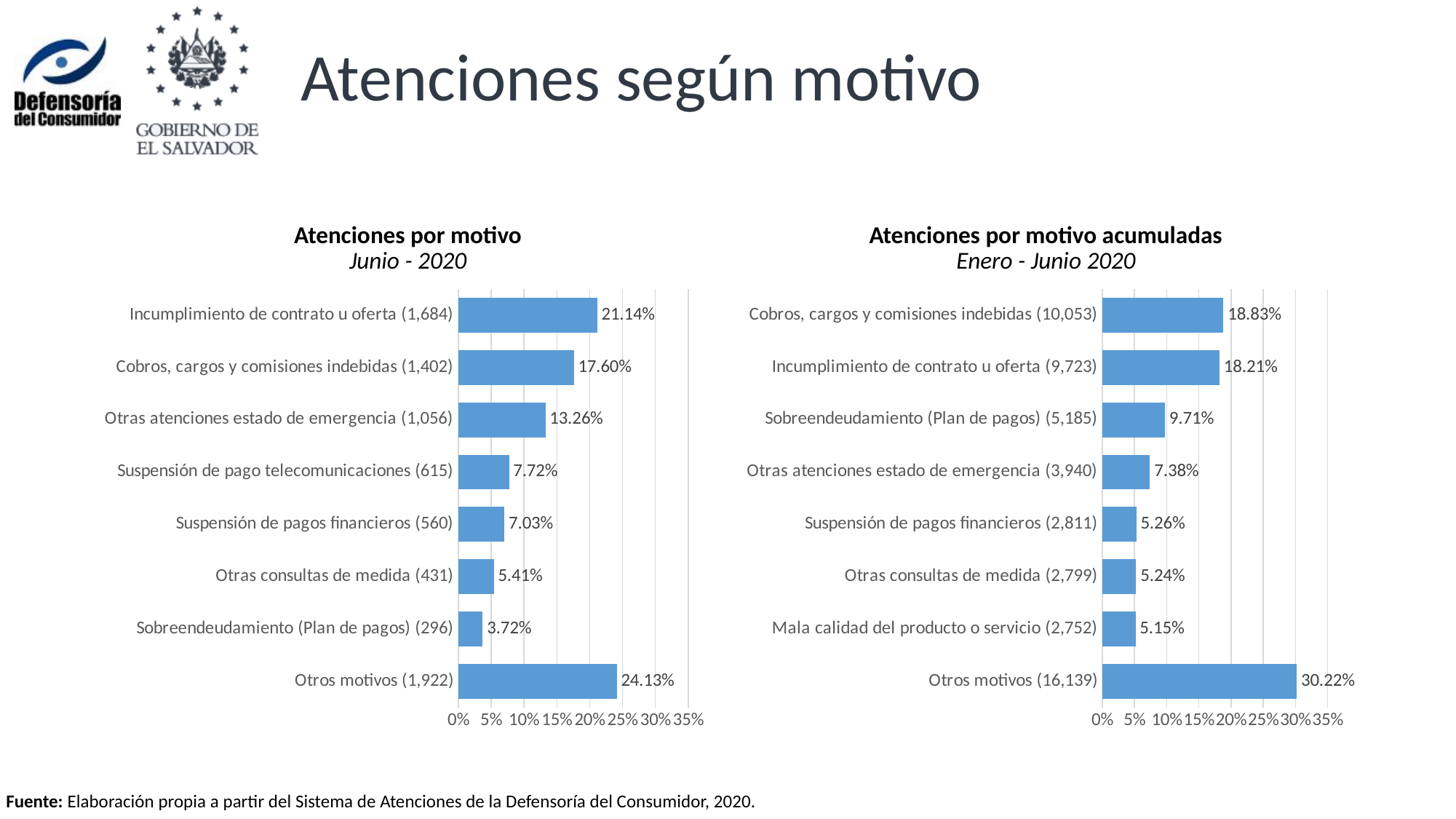
What type of chart is used for 'Atenciones por motivo Junio - 2020'? Bar chart In the 'Atenciones por motivo acumuladas Enero - Junio 2020' chart, what is the count shown in the label for Otros motivos? 16,139 In the 'Atenciones por motivo Junio - 2020' chart, which category has the highest percentage? Otros motivos In the 'Atenciones por motivo acumuladas Enero - Junio 2020' chart, what percentage is shown for Sobreendeudamiento (Plan de pagos)? 9.71% In the 'Atenciones por motivo acumuladas Enero - Junio 2020' chart, which is larger: Otras atenciones estado de emergencia or Suspensión de pagos financieros? Otras atenciones estado de emergencia In the 'Atenciones por motivo Junio - 2020' chart, which category has the lowest percentage? Sobreendeudamiento (Plan de pagos) How many categories are shown in the 'Atenciones por motivo acumuladas Enero - Junio 2020' chart? 8 In the 'Atenciones por motivo Junio - 2020' chart, what percentage is shown for Incumplimiento de contrato u oferta? 21.14% What is the subtitle period shown under the right-hand chart title 'Atenciones por motivo acumuladas'? Enero - Junio 2020 In the 'Atenciones por motivo acumuladas Enero - Junio 2020' chart, which category has the lowest percentage? Mala calidad del producto o servicio In the 'Atenciones por motivo Junio - 2020' chart, is the value for Otras atenciones estado de emergencia greater or less than 10%? greater In the 'Atenciones por motivo Junio - 2020' chart, what is the difference in percentage points between Incumplimiento de contrato u oferta and Cobros, cargos y comisiones indebidas? 3.54 percentage points